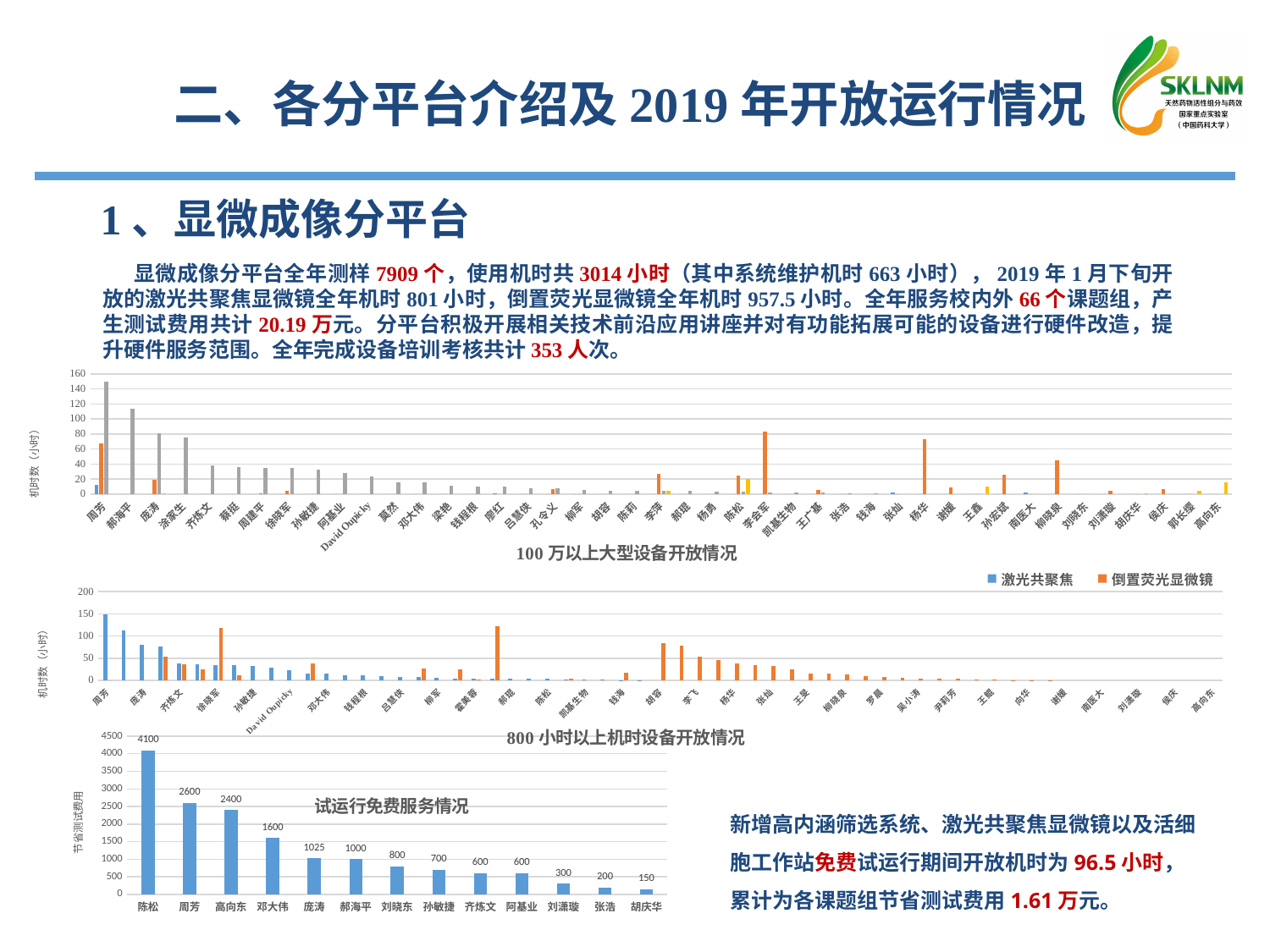
In the chart titled 试运行免费服务情况, what is the difference between the values for 周芳 and 高向东? 200 In the chart titled 试运行免费服务情况, what is the value for 庞涛? 1025 In the chart titled 试运行免费服务情况, what kind of chart is it? bar chart In the chart titled 试运行免费服务情况, which category has the highest value? 陈松 In the chart titled 800小时以上机时设备开放情况, how many series does the legend list? 2 In the chart titled 试运行免费服务情况, what is the value for 胡庆华? 150 In the chart titled 试运行免费服务情况, which is larger, the value for 邓大伟 or the value for 郝海平? 邓大伟 In the chart titled 试运行免费服务情况, how many categories are shown on the x axis? 13 In the chart titled 100万以上大型设备开放情况, is the value of the tallest bar for 周芳 greater or less than 140? greater In the chart titled 试运行免费服务情况, do the values rise or fall from left to right along the x axis? fall In the chart titled 试运行免费服务情况, which category has the lowest value? 胡庆华 In the chart titled 试运行免费服务情况, what is the value for 陈松? 4100